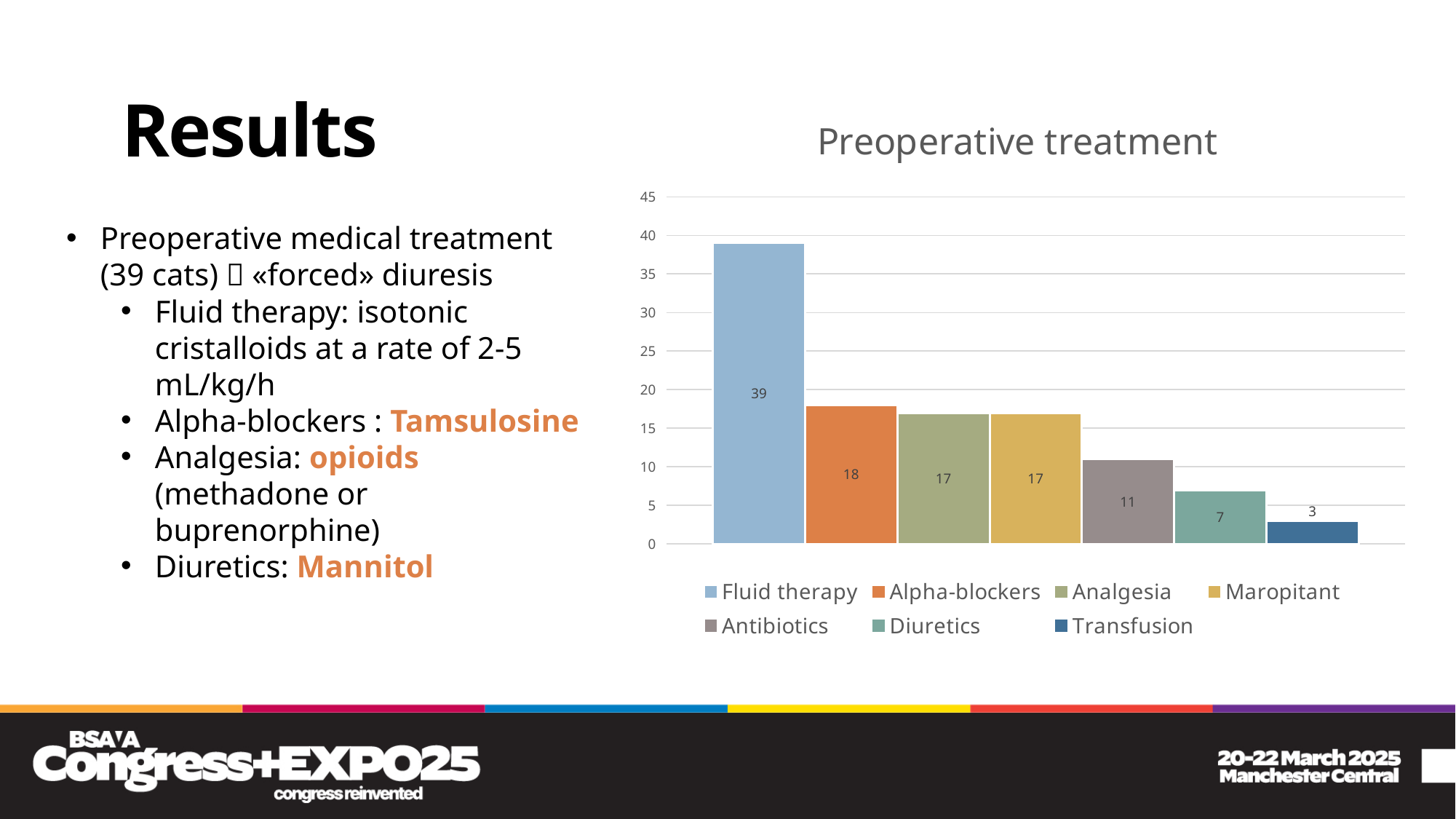
What is the value for Antibiotics in the Preoperative treatment chart? 11 What kind of chart is the Preoperative treatment chart? Bar chart Which is larger, the value for Alpha-blockers or the value for Antibiotics? Alpha-blockers What is the title of the chart on the slide? Preoperative treatment Which treatment has the lowest value in the Preoperative treatment chart? Transfusion What is the value for Fluid therapy in the Preoperative treatment chart? 39 What is the difference between the values for Antibiotics and Diuretics? 4 Is the value for Fluid therapy greater or less than 35? greater Which treatment has the highest value in the Preoperative treatment chart? Fluid therapy What is the difference between the values for Fluid therapy and Alpha-blockers? 21 What is the value for Transfusion in the Preoperative treatment chart? 3 How many treatment categories are shown in the Preoperative treatment chart? 7